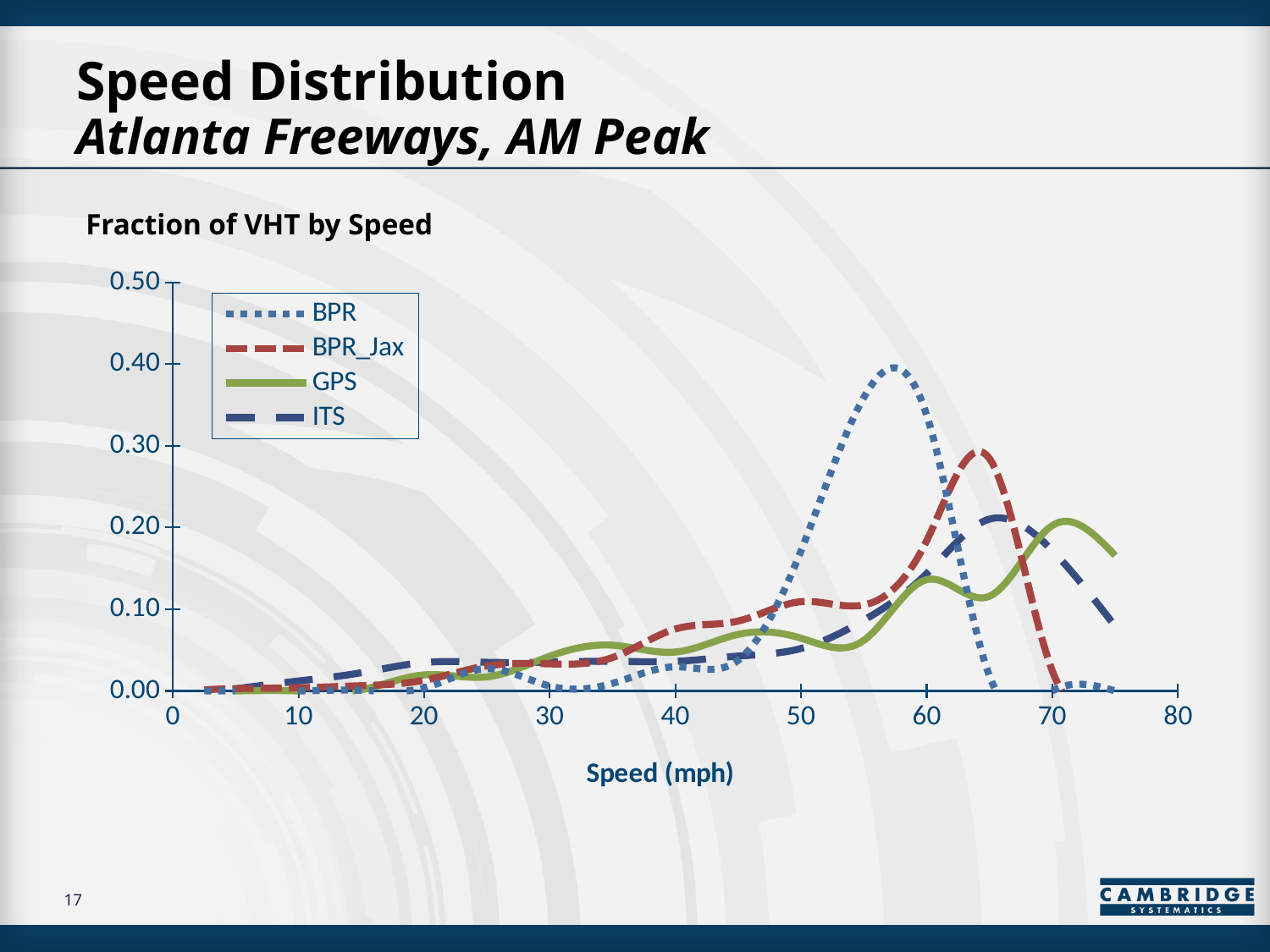
What is the label of the x axis? Speed (mph) Which has a higher peak value, the BPR series or the BPR_Jax series? BPR Is the peak value of the BPR_Jax series greater or less than 0.20? greater Is the value of the GPS series at 60 mph greater or less than 0.10? greater Does the BPR series rise or fall between 50 mph and 55 mph? rise Which has a higher peak value, the BPR_Jax series or the GPS series? BPR_Jax Which series reaches the highest peak value? BPR Is the value of the BPR series at 40 mph greater or less than 0.10? less How many series does the legend list? 4 What kind of chart is shown on the slide? line chart What are the series names listed in the legend? BPR, BPR_Jax, GPS, ITS